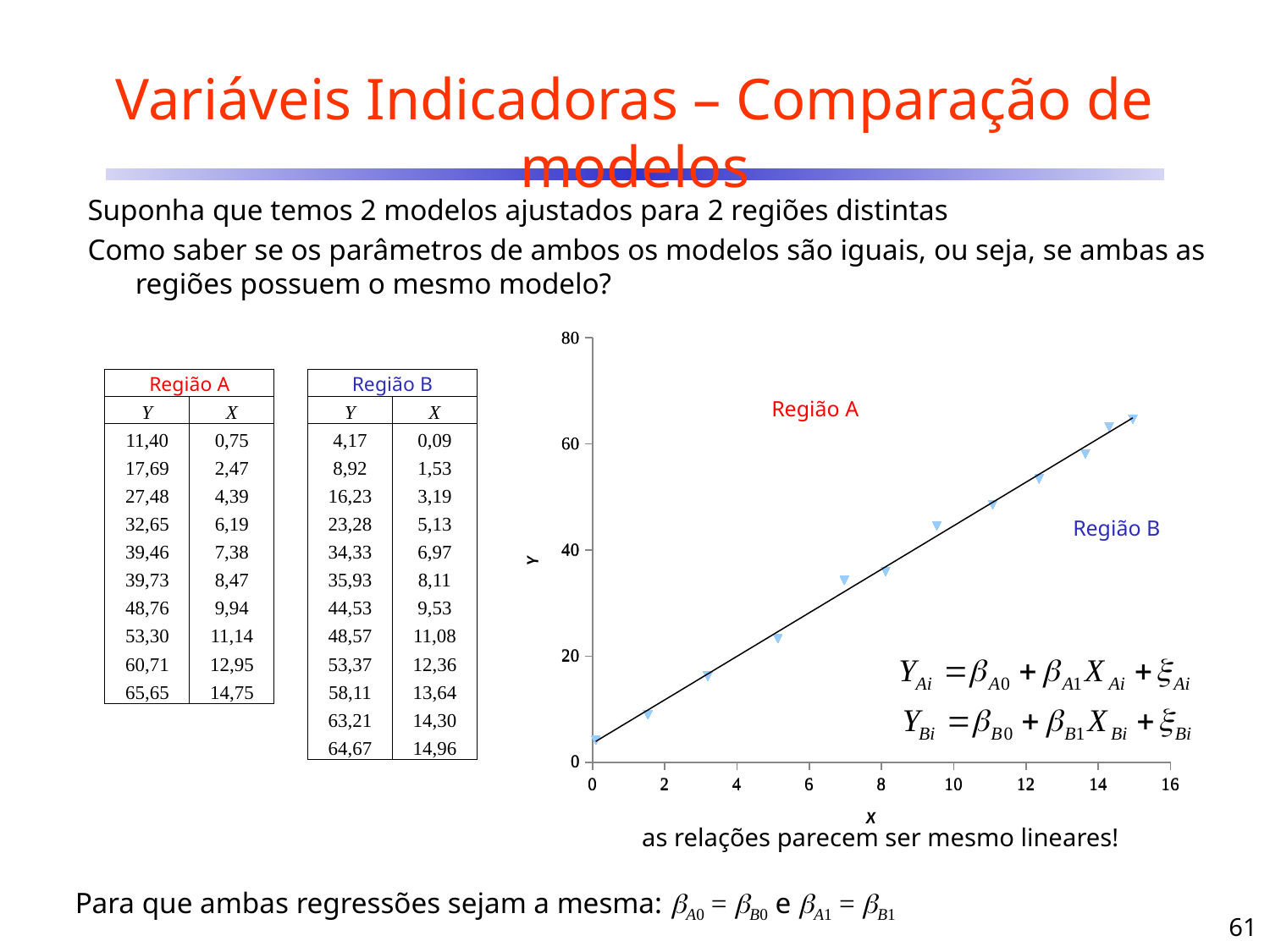
What is the highest tick value shown on the Y axis? 80 Is the Y value of the rightmost point (near X = 15) greater or less than 60? greater Do the plotted Y values rise or fall as X increases? rise Is the Y value of the leftmost point (near X = 0) greater or less than 20? less Which point has the highest Y value: the one near X = 3 or the one near X = 13? the one near X = 13 What kind of chart is shown on the slide? scatter chart What is the label of the horizontal axis of the chart? X How many data points are plotted on the chart? 12 Is the Y value of the point near X = 8 greater or less than 40? less